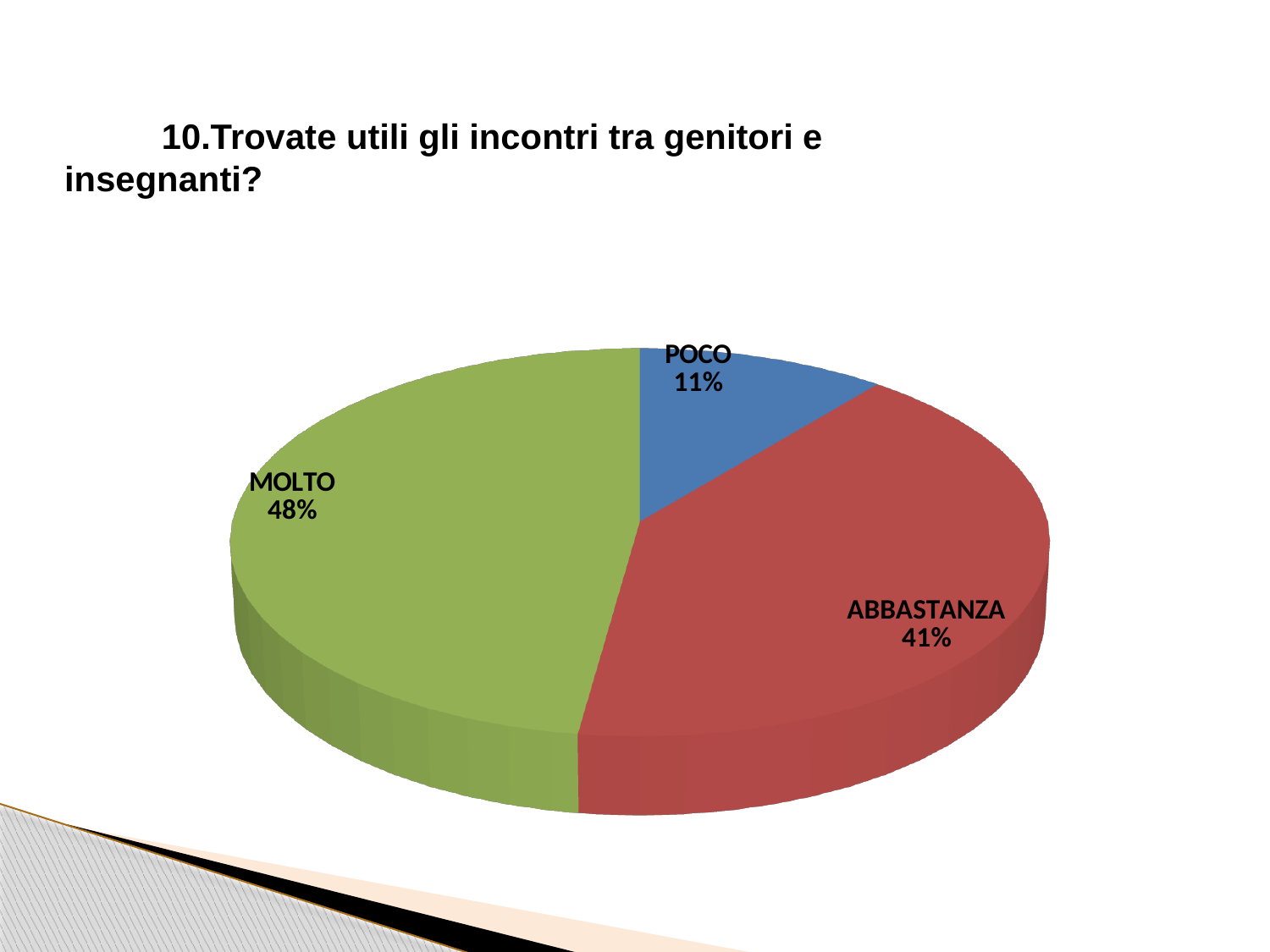
What percentage of respondents answered ABBASTANZA? 41% How many slices does the pie chart have? 3 Which is larger, the share for ABBASTANZA or the share for POCO? ABBASTANZA Which response has the largest share of the pie? MOLTO What percentage of respondents answered MOLTO? 48% What is the difference in percentage points between MOLTO and ABBASTANZA? 7 Which response has the smallest share of the pie? POCO What kind of chart is shown on the slide? pie chart What percentage of respondents answered POCO? 11% What question does the chart title ask? 10.Trovate utili gli incontri tra genitori e insegnanti? What colour is the MOLTO slice? green What is the difference in percentage points between ABBASTANZA and POCO? 30